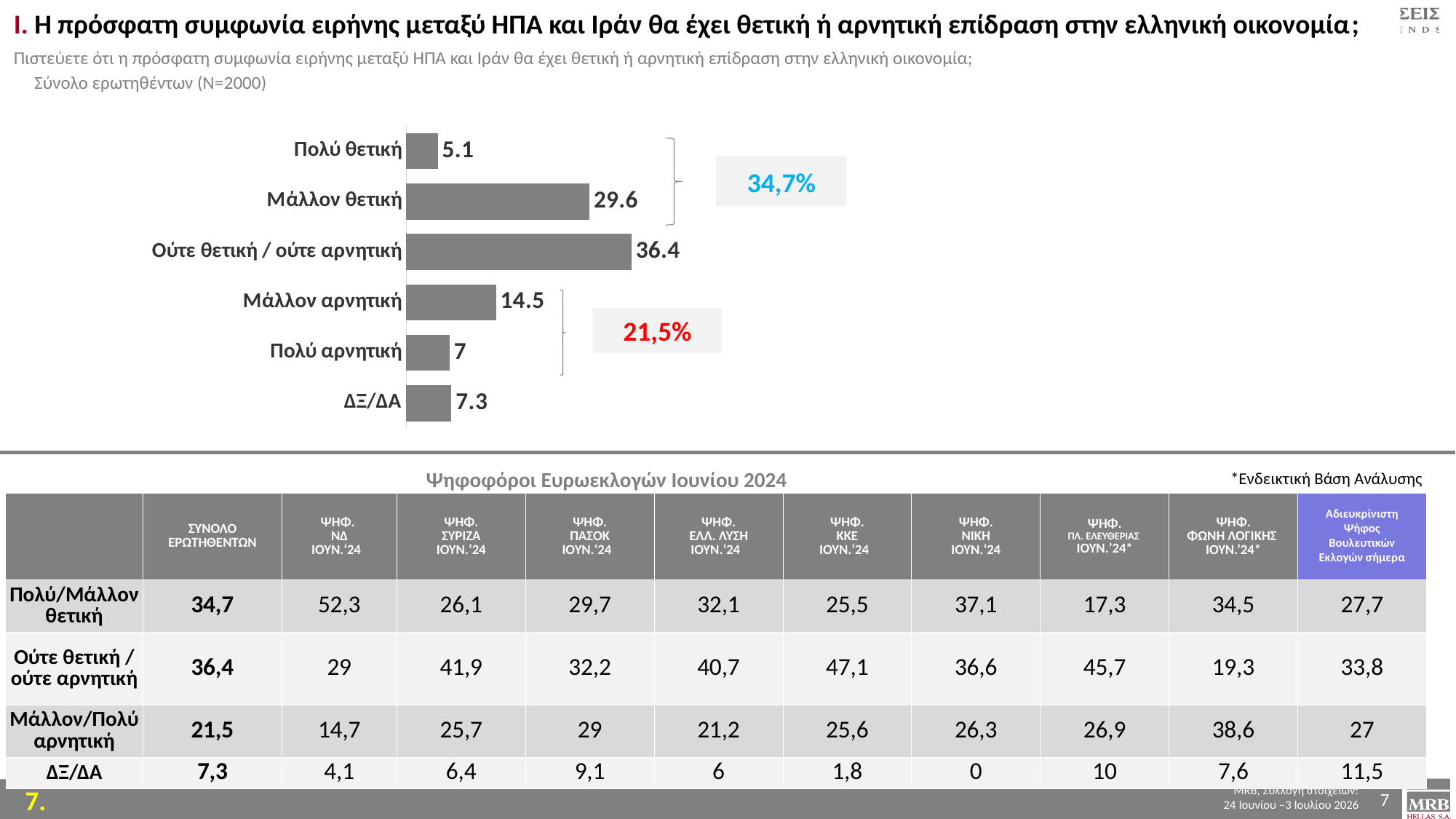
What is the difference between the values for 'Ούτε θετική / ούτε αρνητική' and 'Μάλλον θετική'? 6.8 What value is shown for the bar labelled 'Πολύ αρνητική'? 7 Which category has the lowest value in the bar chart? Πολύ θετική What value is shown for the bar labelled 'Μάλλον θετική'? 29.6 What is the difference between the values for 'Μάλλον αρνητική' and 'Πολύ αρνητική'? 7.5 What combined percentage is shown in the box next to the two negative categories ('Μάλλον αρνητική' and 'Πολύ αρνητική')? 21,5% What combined percentage is shown in the box next to the two positive categories ('Πολύ θετική' and 'Μάλλον θετική')? 34,7% Which is larger, the value for 'ΔΞ/ΔΑ' or the value for 'Πολύ θετική'? ΔΞ/ΔΑ What value is shown for the bar labelled 'ΔΞ/ΔΑ'? 7.3 Which category has the highest value in the bar chart? Ούτε θετική / ούτε αρνητική How many categories are plotted in the bar chart? 6 What type of chart is shown on the slide? Bar chart